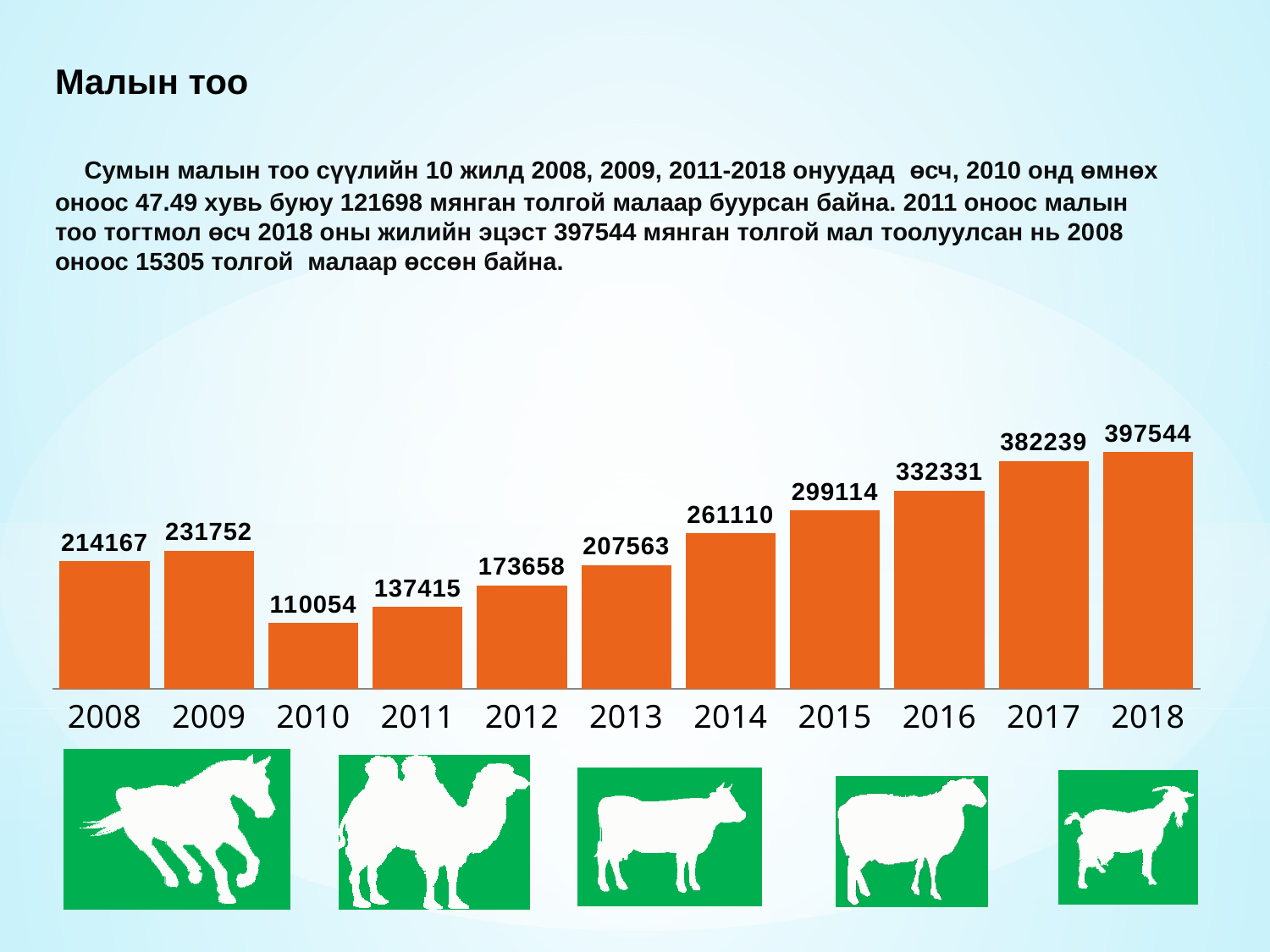
What is the value shown for 2014? 261110 What is the difference between the values for 2018 and 2008? 183377 Do the values rise or fall from 2011 to 2018? Rise What is the difference between the values for 2009 and 2010? 121698 What colour are the bars in the chart? Orange What is the value shown for 2010? 110054 What kind of chart is shown on the slide? Bar chart Which year has the highest value? 2018 Which is larger, the value for 2012 or the value for 2013? 2013 Which year has the lowest value? 2010 What is the value shown for 2018? 397544 How many years are shown on the x axis? 11